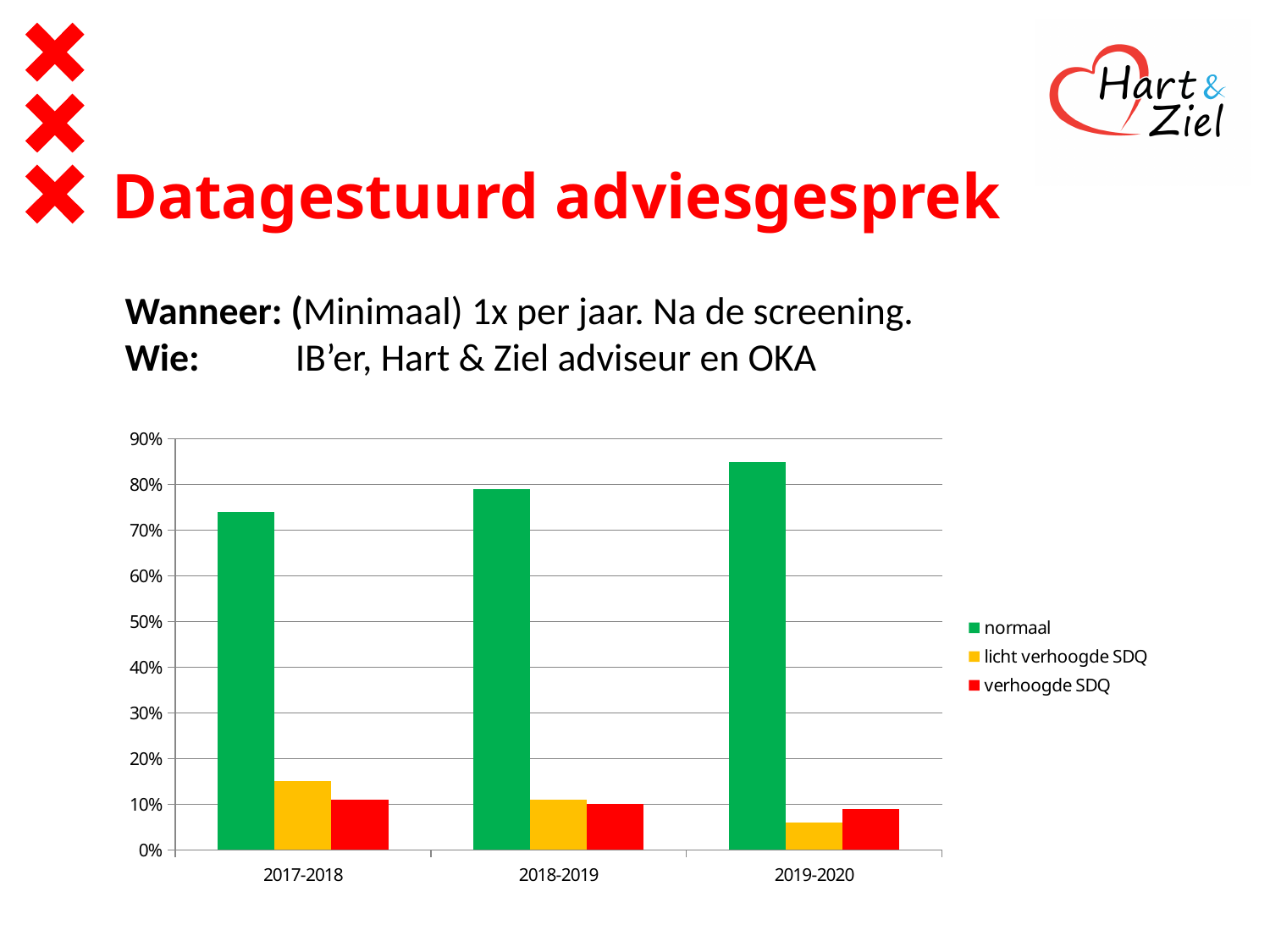
In 2017-2018, which is larger: licht verhoogde SDQ or verhoogde SDQ? licht verhoogde SDQ Does the value for normaal rise or fall from 2017-2018 to 2019-2020? rise Which school year has the lowest value for normaal? 2017-2018 Which school year has the lowest value for licht verhoogde SDQ? 2019-2020 Is the value for normaal in 2019-2020 greater or less than 80%? greater What colour are the bars for verhoogde SDQ? red How many series does the legend list? 3 Is the value for normaal in 2017-2018 greater or less than 70%? greater Is the value for licht verhoogde SDQ in 2019-2020 greater or less than 10%? less Which school year has the highest value for normaal? 2019-2020 What kind of chart is shown on the slide? bar chart How many school years are shown on the x axis? 3